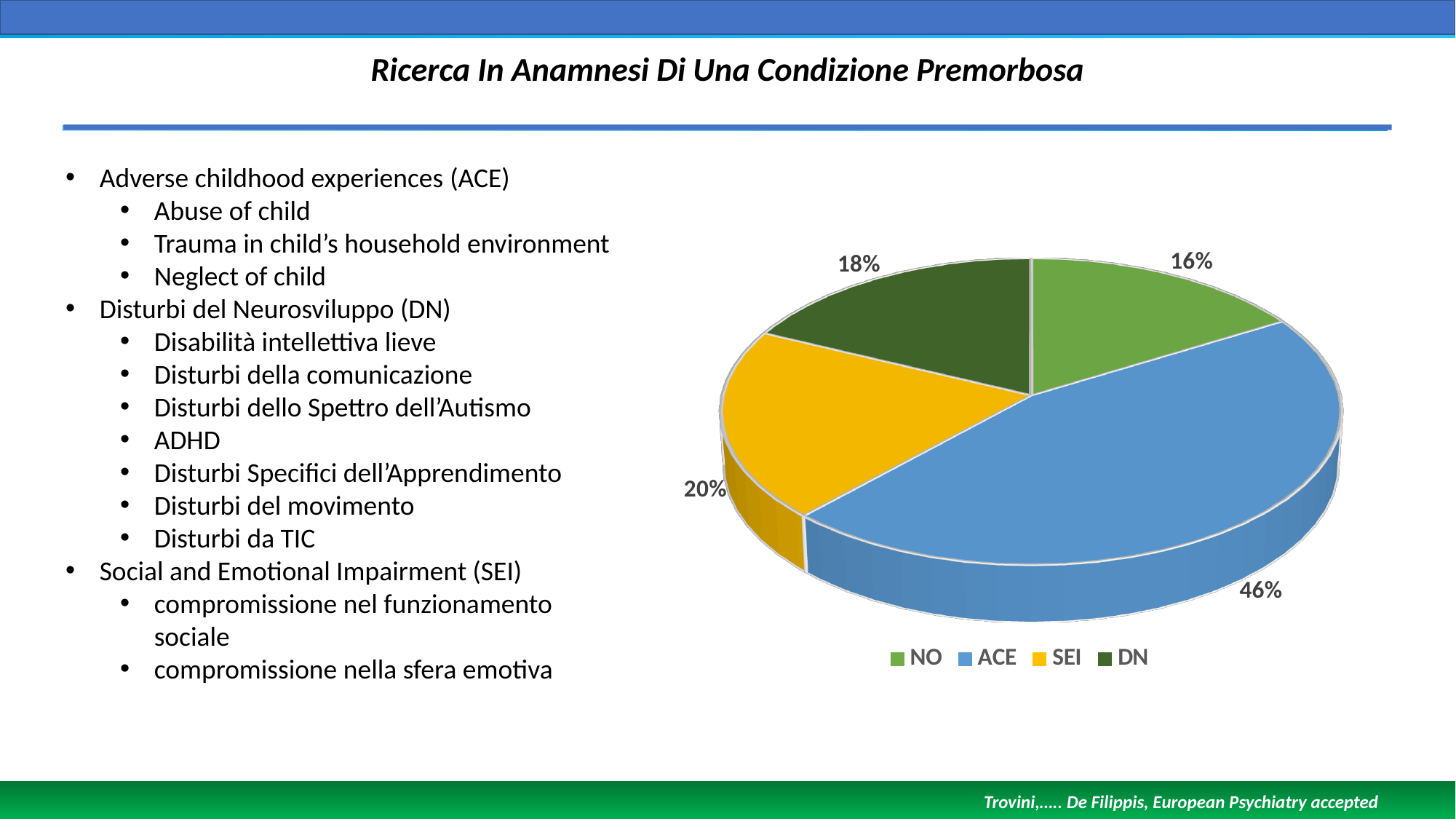
How many entries does the legend of the pie chart list? 4 What percentage of the pie chart is NO? 16% What is the difference in percentage points between the ACE slice and the SEI slice? 26 How many slices does the pie chart have? 4 What percentage of the pie chart is DN? 18% What percentage of the pie chart is ACE? 46% Which category has the smallest slice of the pie chart? NO What percentage of the pie chart is SEI? 20% What kind of chart is shown on the slide? pie chart What colour is the ACE slice in the pie chart? blue Which category has the largest slice of the pie chart? ACE Which slice is larger, SEI or DN? SEI